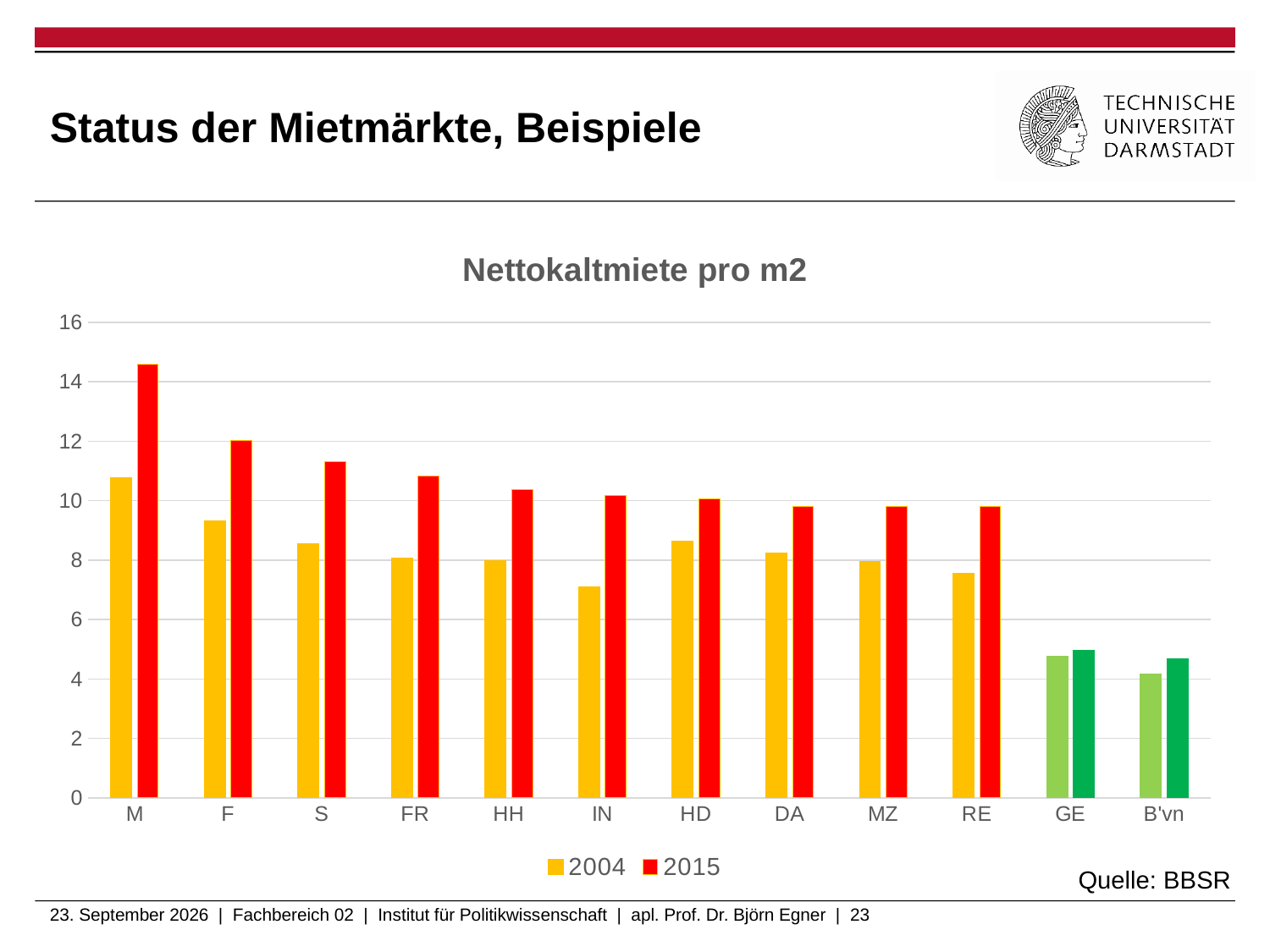
How many series does the legend list? 2 Is the 2004 value for IN greater or less than 8? less What kind of chart is shown on the slide? bar chart Is the 2015 value for S greater or less than 12? less Which is larger, the 2015 value for M or the 2015 value for F? M How many categories are shown on the x axis? 12 What is the title of the chart? Nettokaltmiete pro m2 Is the 2015 value for GE greater or less than 6? less Do the 2015 values generally rise or fall from left to right along the x axis? fall Which category has the lowest 2004 value? B'vn Which category has the highest 2015 value? M